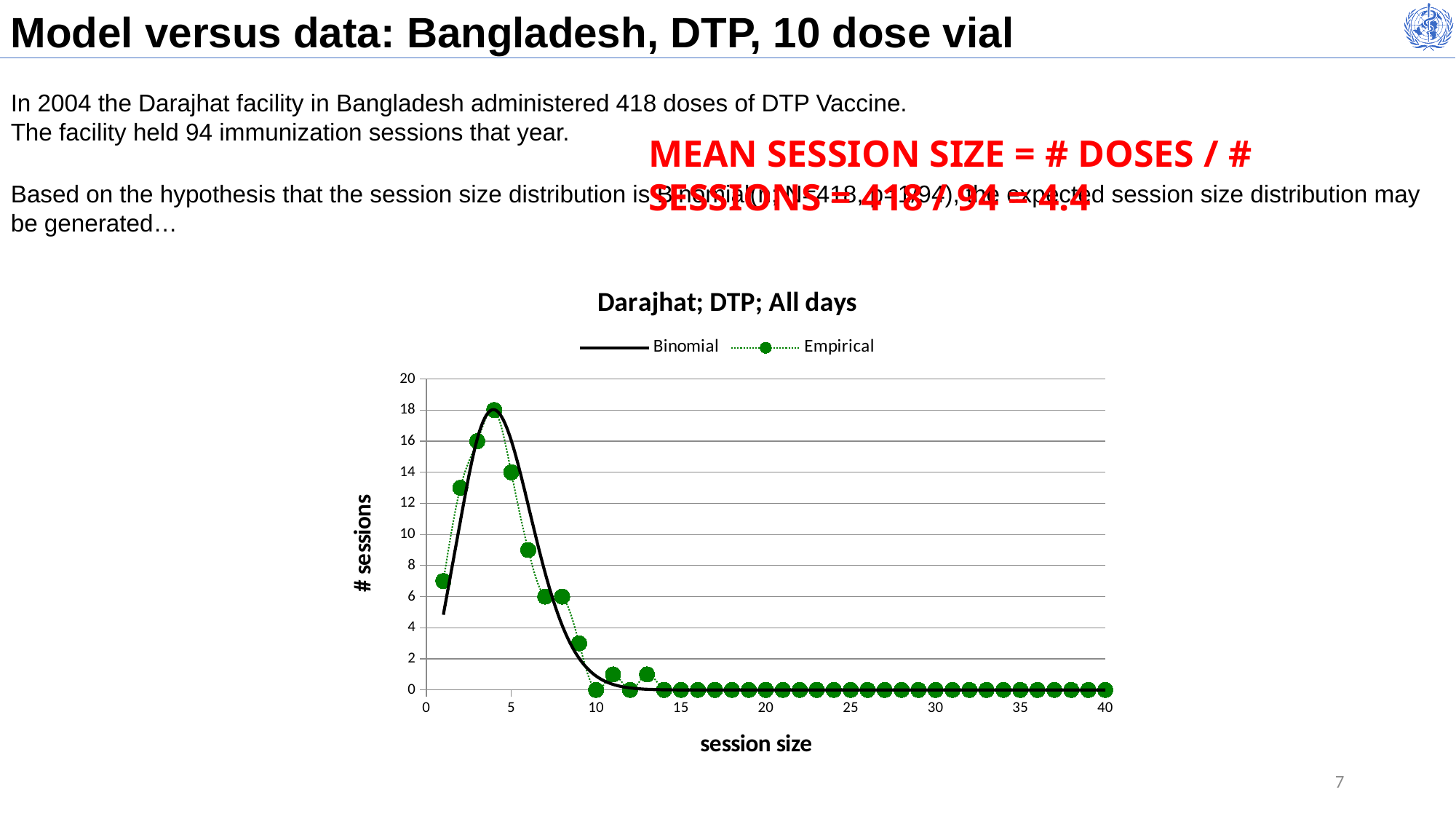
What kind of chart is shown on the slide? line chart What are the two series named in the chart legend? Binomial and Empirical What is the title of the chart? Darajhat; DTP; All days What is the Empirical number of sessions at session size 5? 14 Is the Empirical value at session size 9 greater or less than 4? less What is the Empirical number of sessions at session size 4? 18 Do the Empirical values rise or fall as session size increases from 4 to 10? fall Which is larger for the Empirical series: the value at session size 3 or at session size 6? session size 3 How many series does the chart legend list? 2 What is the Empirical number of sessions at session size 3? 16 Is the Empirical value at session size 2 greater or less than 12? greater At which session size does the Empirical series reach its highest number of sessions? 4